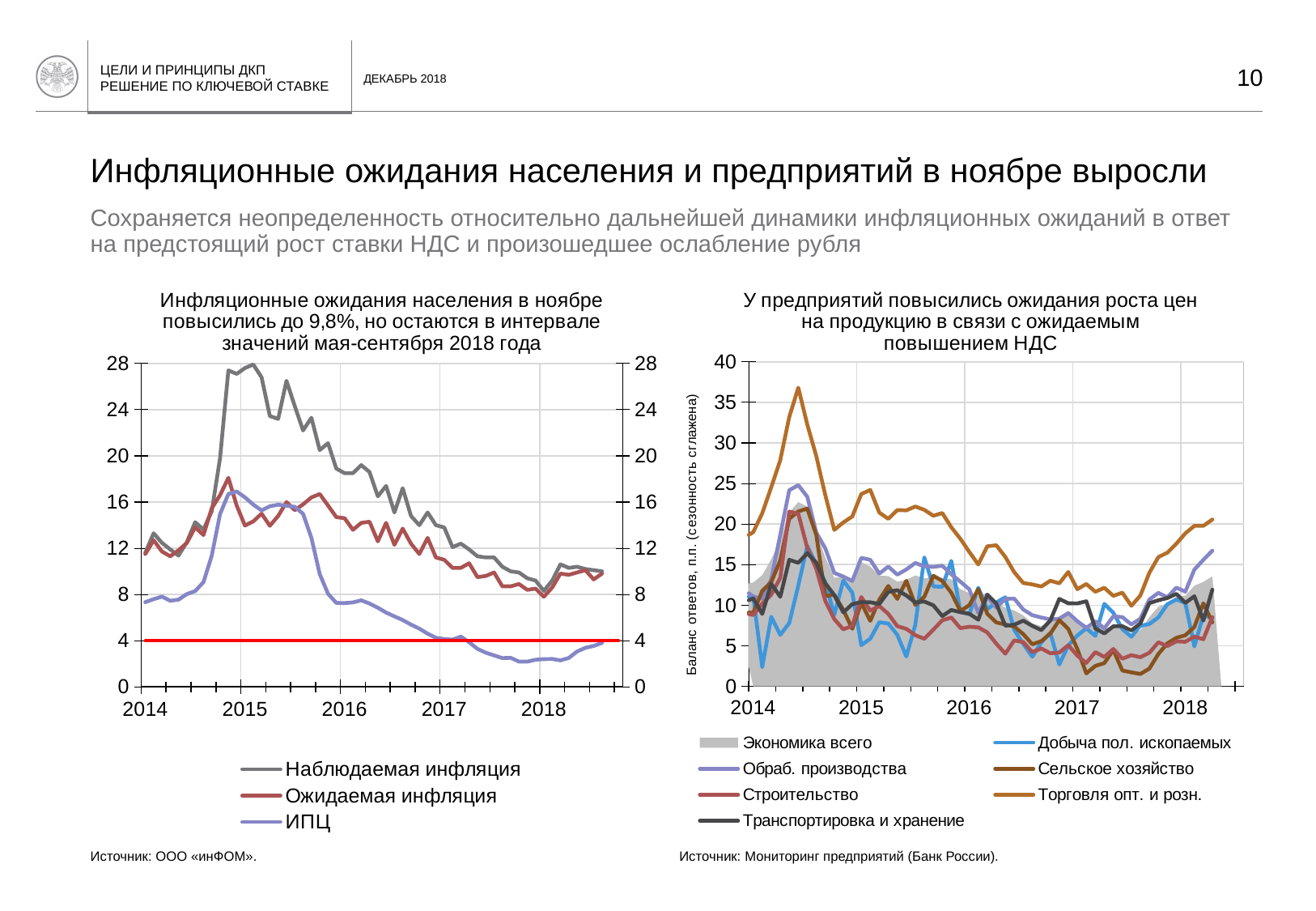
How many series does the legend of the right chart, titled 'У предприятий повысились ожидания роста цен...', list? 7 In the left chart, is the peak value of 'Наблюдаемая инфляция' in early 2015 greater or less than 24? greater In the right chart, at the 2014 peak, which is larger: 'Торговля опт. и розн.' or 'Обраб. производства'? Торговля опт. и розн. In the right chart, is the peak value of 'Торговля опт. и розн.' in 2014 greater or less than 30? greater What kind of chart is the left chart, titled 'Инфляционные ожидания населения в ноябре повысились до 9,8%...'? Line chart In the left chart, is the value of 'ИПЦ' at the start of 2018 greater or less than 4? less In the right chart, which series reaches the highest value on the chart? Торговля опт. и розн. In the left chart, at what level is the horizontal red line drawn? 4 In the left chart, does 'Наблюдаемая инфляция' rise or fall from 2015 to 2018? Fall What is the y-axis label of the right chart? Баланс ответов, п.п. (сезонность сглажена) How many series does the legend of the left chart list? 3